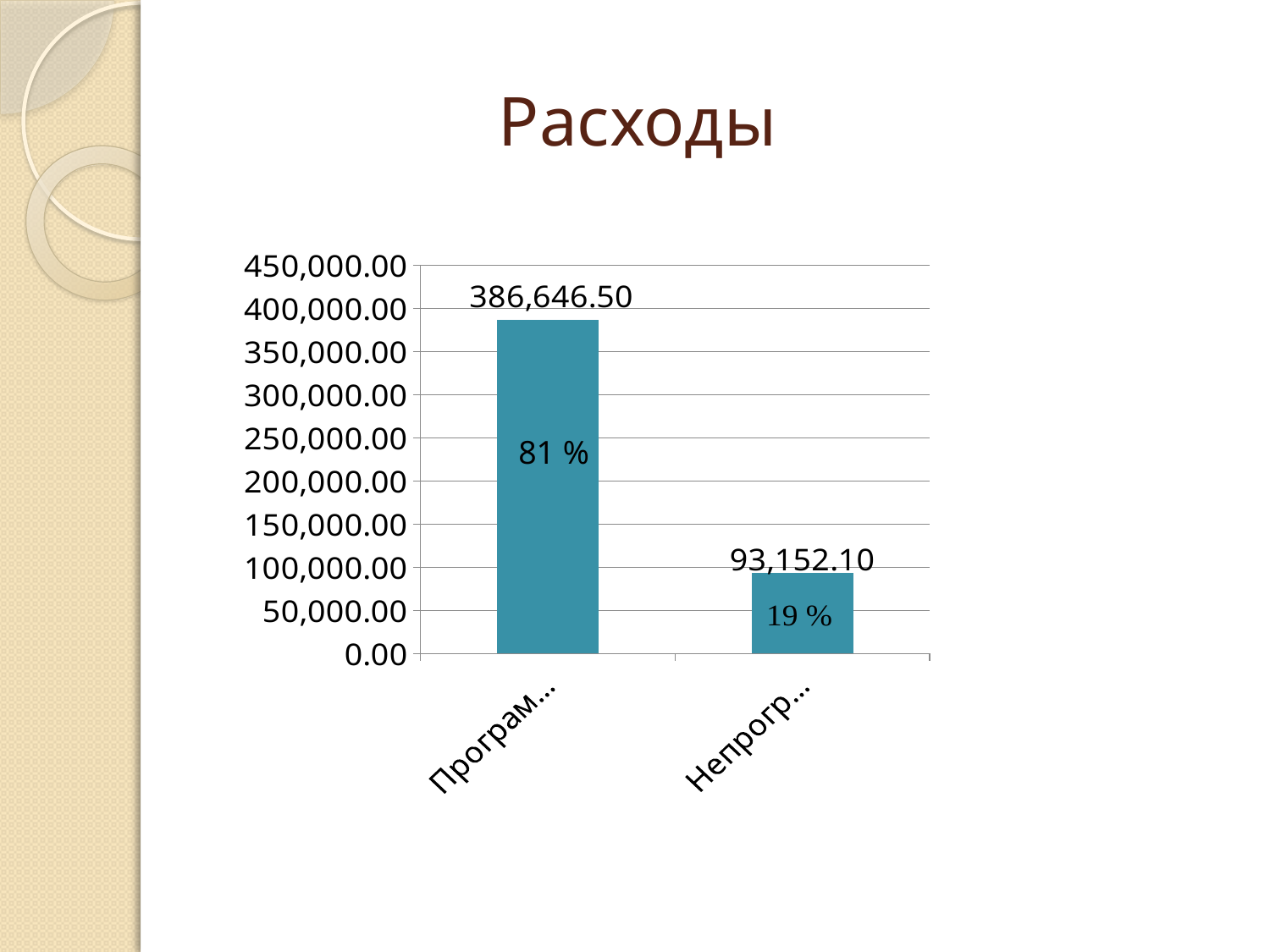
What value is labelled on the left bar (Програм…)? 386,646.50 What is the difference between the left bar value and the right bar value? 293,494.40 What value is labelled on the right bar (Непрогр…)? 93,152.10 Which bar is the highest? the left bar (Програм…) Which bar is the lowest? the right bar (Непрогр…) What is the title of the chart on the slide? Расходы What kind of chart is shown on the slide? bar chart What percentage is printed inside the left bar (Програм…)? 81 % Is the value for the left bar (Програм…) greater or less than 350,000.00? greater How many bars does the chart have? 2 What percentage is printed inside the right bar (Непрогр…)? 19 % Is the value for the right bar (Непрогр…) greater or less than 100,000.00? less